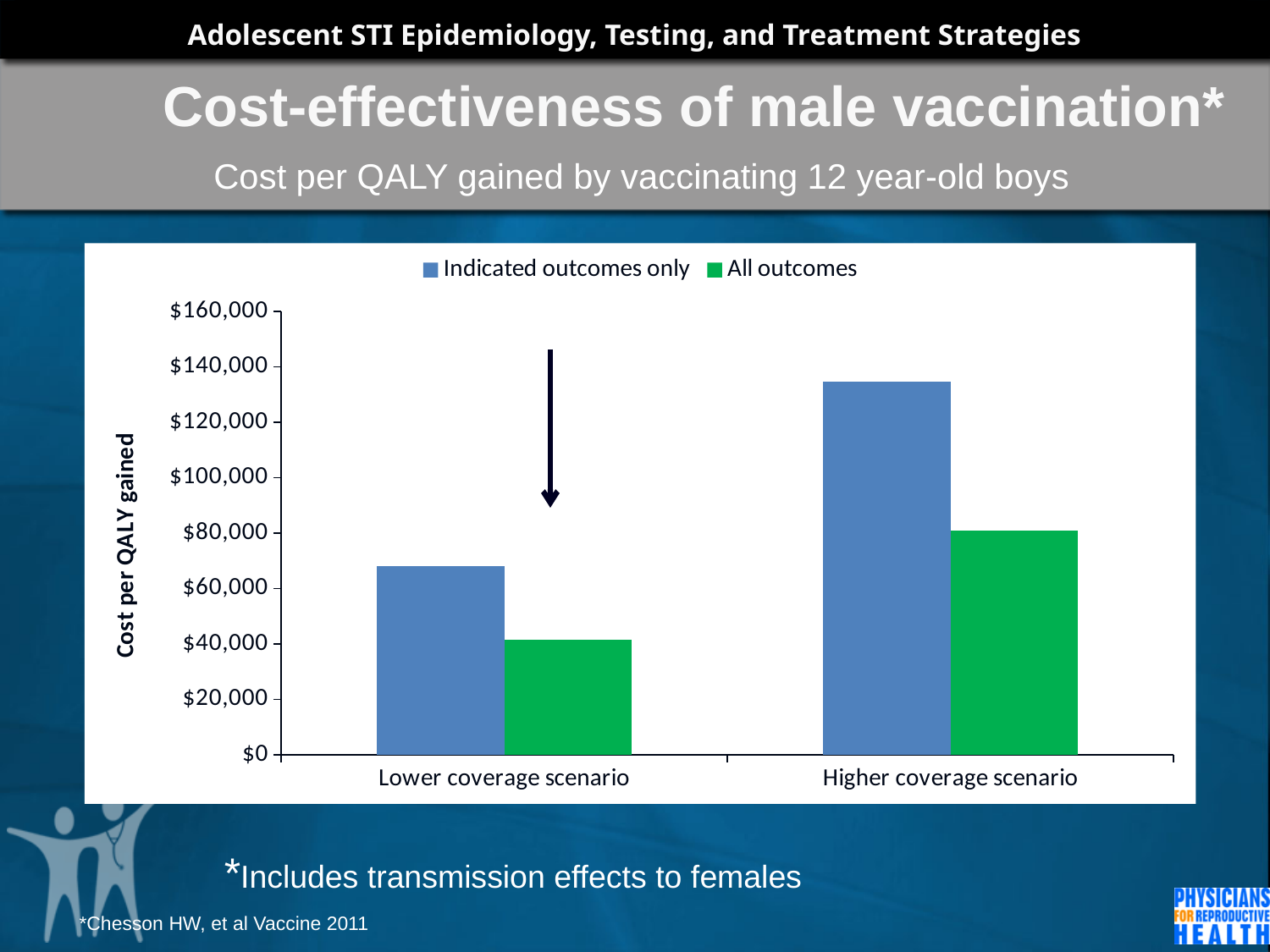
Is the value for All outcomes in the Higher coverage scenario greater or less than $100,000? less Which bar is the tallest in the chart? Indicated outcomes only, Higher coverage scenario Is the value for Indicated outcomes only in the Lower coverage scenario greater or less than $60,000? greater Which bar is the shortest in the chart? All outcomes, Lower coverage scenario Is the value for Indicated outcomes only in the Higher coverage scenario greater or less than $120,000? greater What kind of chart is shown on the slide? bar chart In the Higher coverage scenario, which is larger: Indicated outcomes only or All outcomes? Indicated outcomes only Which scenario has the higher All outcomes value: Lower coverage or Higher coverage? Higher coverage scenario What is the label of the y axis? Cost per QALY gained How many series does the legend list? 2 How many coverage scenarios are shown on the x axis? 2